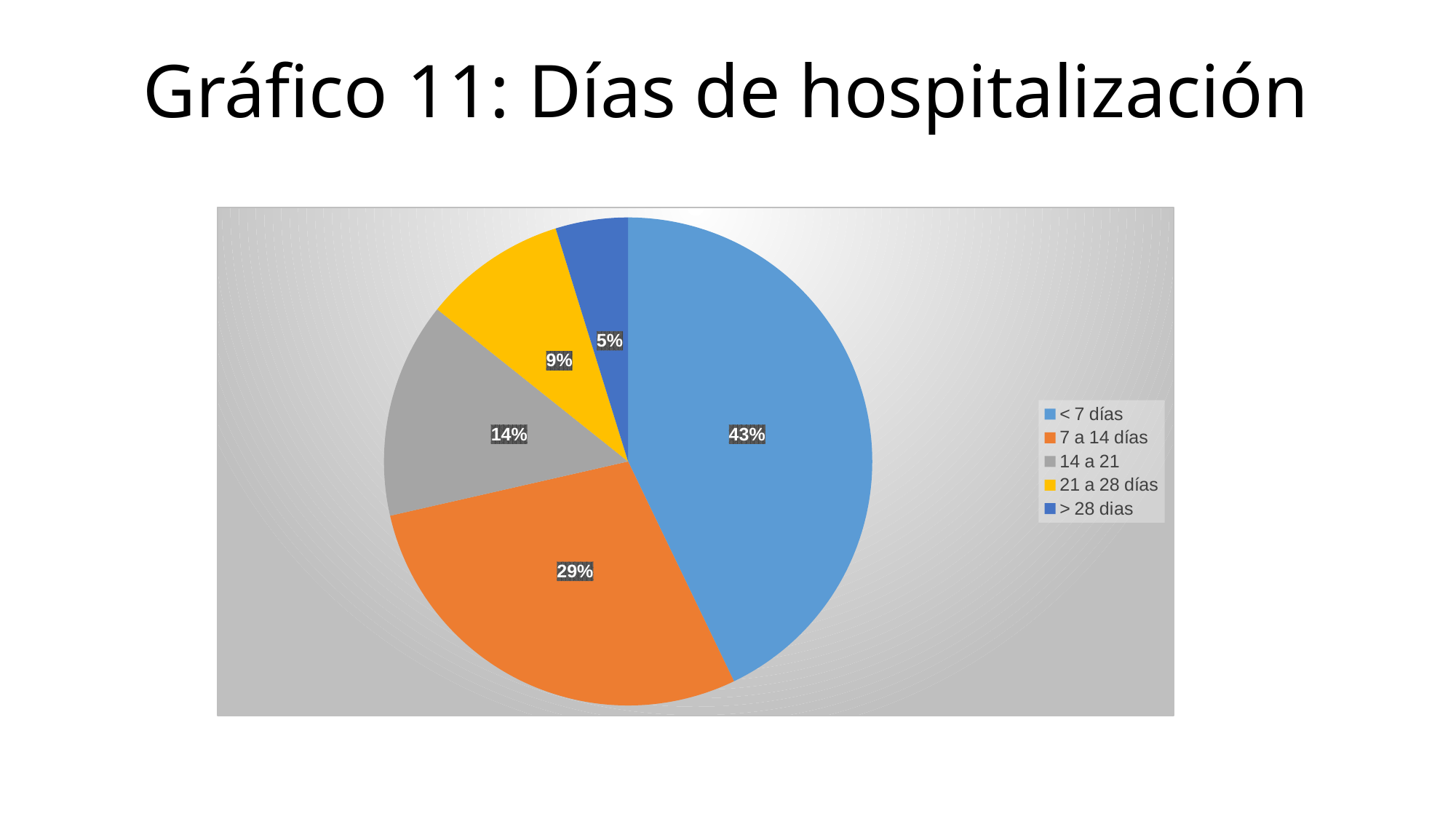
What share of the pie does the '< 7 días' slice represent? 43% What is the value shown for the '21 a 28 días' slice? 9% Which is larger, the '14 a 21' slice or the '21 a 28 días' slice? 14 a 21 What share of the pie does the '7 a 14 días' slice represent? 29% What is the title of the slide? Gráfico 11: Días de hospitalización How many categories does the pie chart show? 5 What kind of chart is shown on the slide? Pie chart What is the value shown for the '14 a 21' slice? 14% Which category has the largest share of the pie? < 7 días Which category has the smallest share of the pie? > 28 dias What is the value shown for the '> 28 dias' slice? 5% What is the difference in percentage points between the '< 7 días' and '7 a 14 días' slices? 14